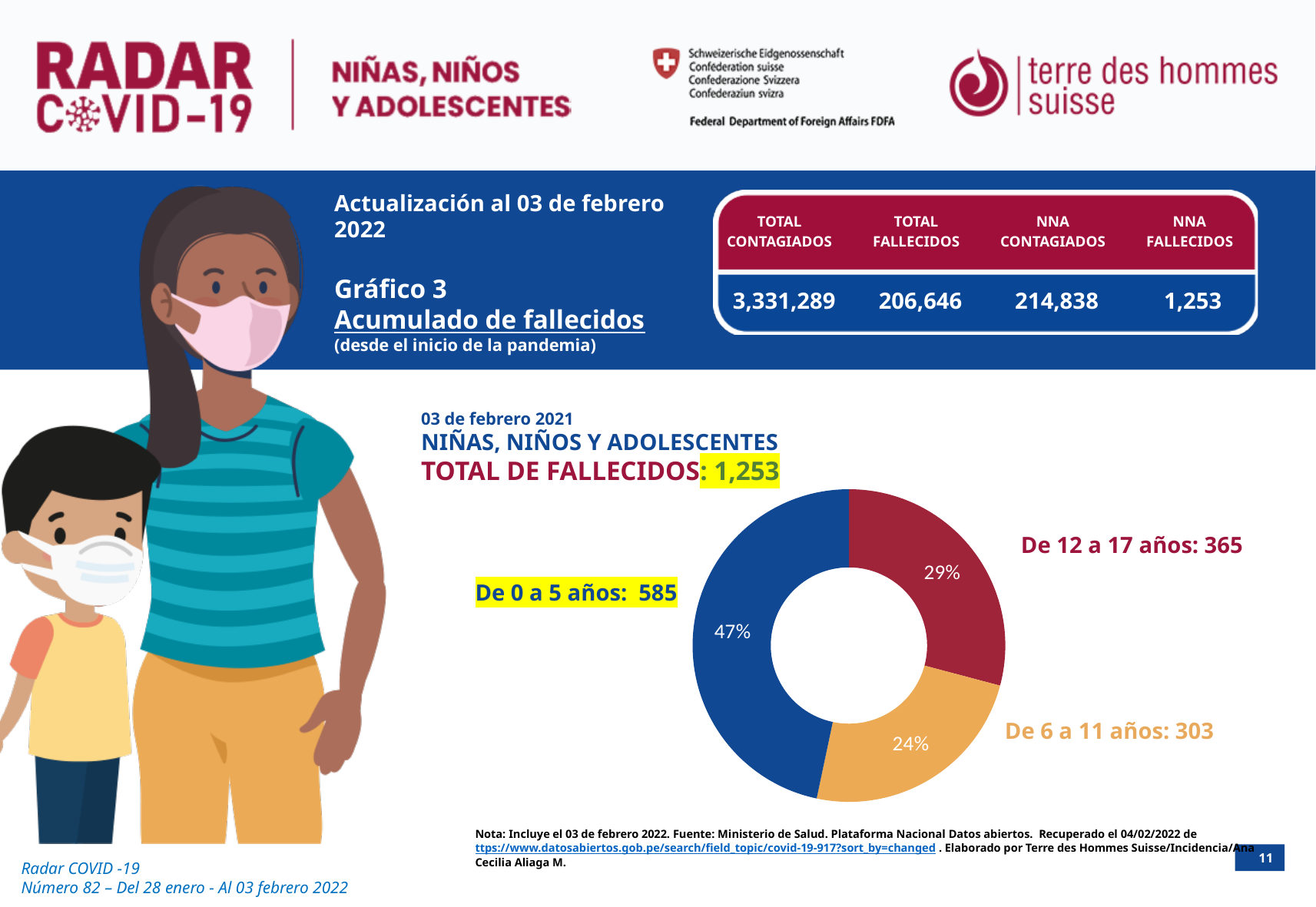
What is the number of deaths for the group 'De 12 a 17 años'? 365 What is the total number of deaths shown for niñas, niños y adolescentes in the chart? 1,253 How many age groups are shown in the pie chart? 3 What percentage of the pie chart corresponds to the group 'De 6 a 11 años'? 24% What is the number of deaths for the group 'De 6 a 11 años'? 303 Which group has more deaths, 'De 12 a 17 años' or 'De 6 a 11 años'? De 12 a 17 años What percentage of the pie chart corresponds to the group 'De 0 a 5 años'? 47% What is the number of deaths for the group 'De 0 a 5 años'? 585 What kind of chart is shown on the slide? Pie chart (donut) Which age group has the largest share of the pie chart? De 0 a 5 años Which age group has the smallest share of the pie chart? De 6 a 11 años What is the difference in deaths between the group 'De 0 a 5 años' and the group 'De 12 a 17 años'? 220